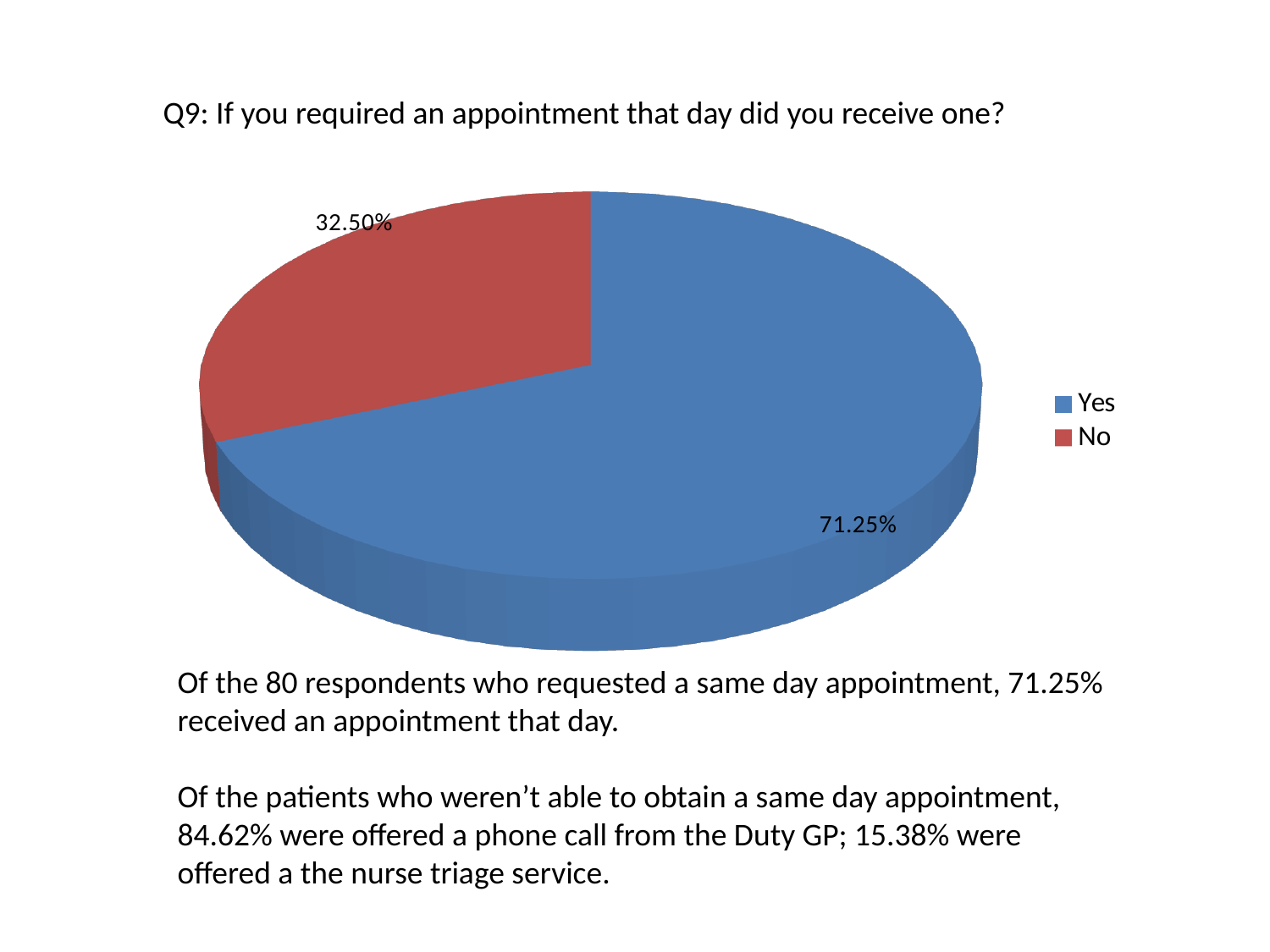
How many entries does the legend of the pie chart list? 2 Which slice of the pie chart is the smallest? No What percentage is shown for the Yes slice of the pie chart? 71.25% Which slice of the pie chart is the largest? Yes What percentage is shown for the No slice of the pie chart? 32.50% Which is larger in the pie chart, Yes or No? Yes What kind of chart is shown on the slide? pie chart What colour is the Yes slice in the pie chart? blue What colour is the No slice in the pie chart? red How many slices does the pie chart have? 2 What is the difference in percentage points between the Yes and No slices as labelled on the pie chart? 38.75